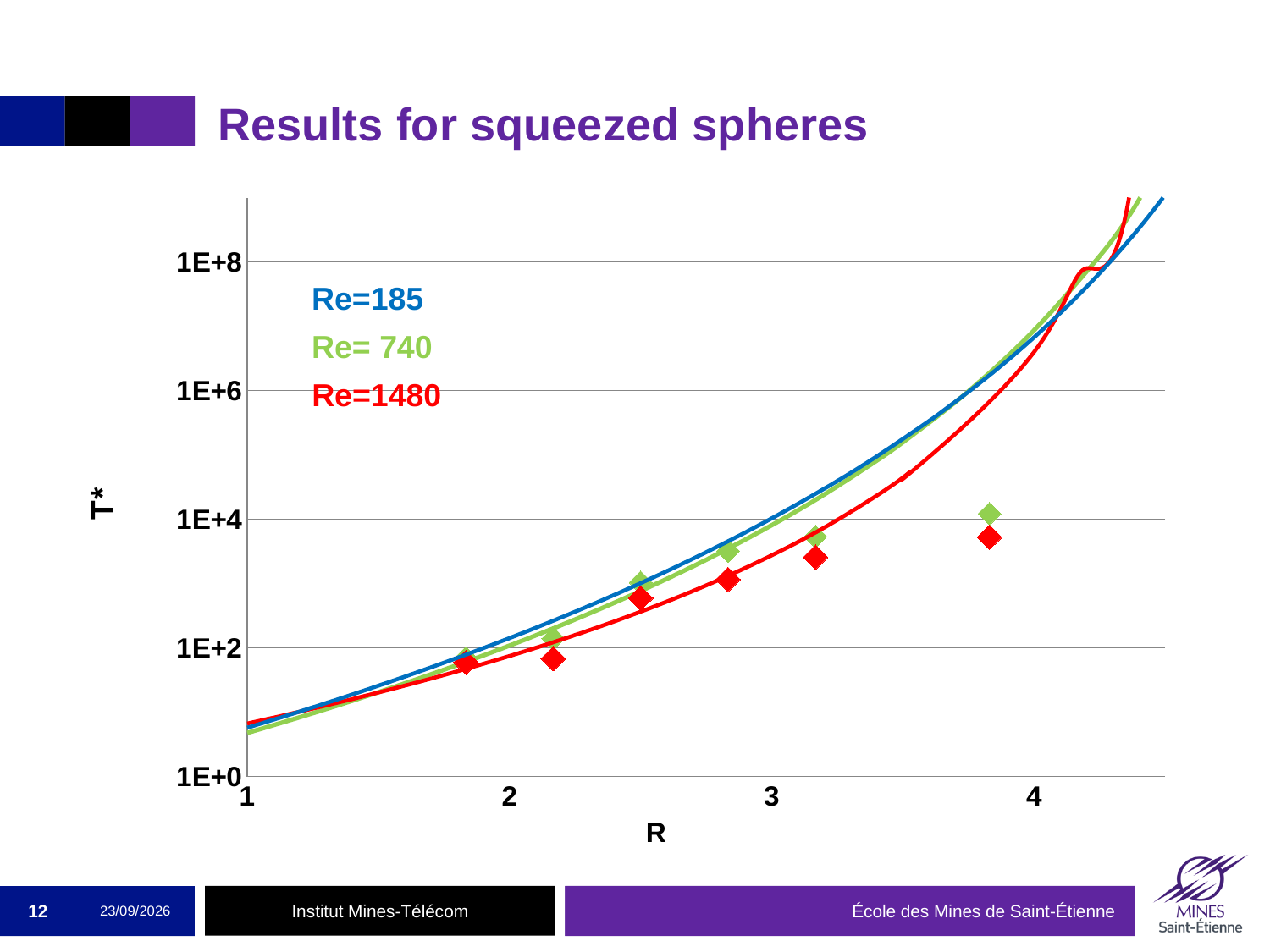
Near R=3.8, which diamond marker is higher: the green Re=740 one or the red Re=1480 one? green Re=740 How many red diamond markers are plotted for Re=1480? 6 What is the label of the y axis? T* Does T* rise or fall as R increases for the Re=185 curve? rise What kind of chart is shown on the slide? line chart with scatter markers Which Re value is plotted in red? Re=1480 Is the value of the blue Re=185 curve at R=4 greater or less than 1E+6? greater What is the label of the x axis? R At R=3.5, which of the three curves is the lowest? Re=1480 How many series (Re values) are labelled on the chart? 3 Is the value of the red Re=1480 diamond marker near R=3.8 greater or less than 1E+4? less Is the value of the red Re=1480 diamond marker near R=2.2 greater or less than 1E+2? less